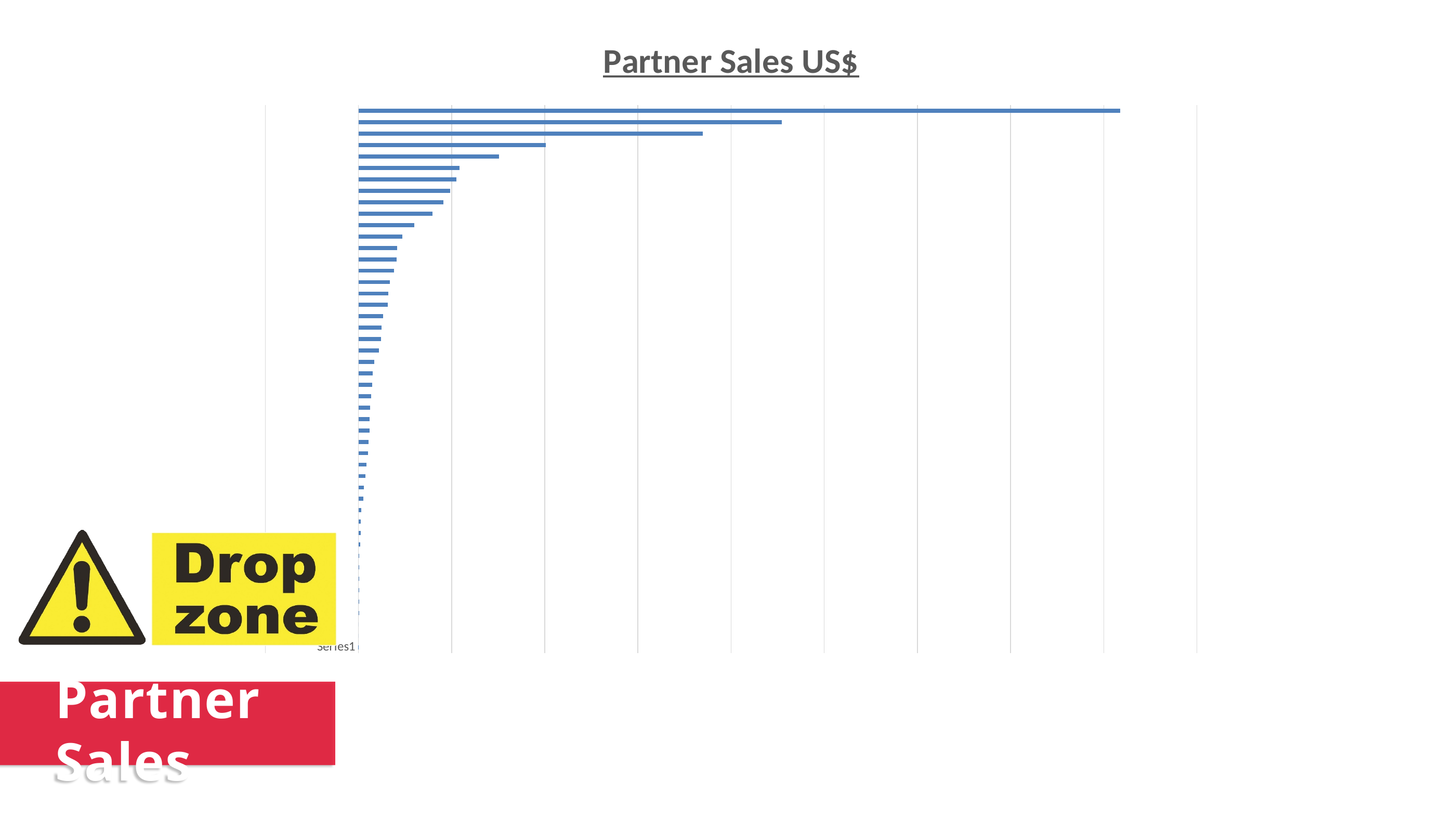
What is the title of the chart? Partner Sales US$ Do the bar lengths increase or decrease from the top of the chart to the bottom? decrease What kind of chart is shown on the slide? bar chart Is the longest bar in the chart at the top or at the bottom? top What colour are the bars in the chart? blue